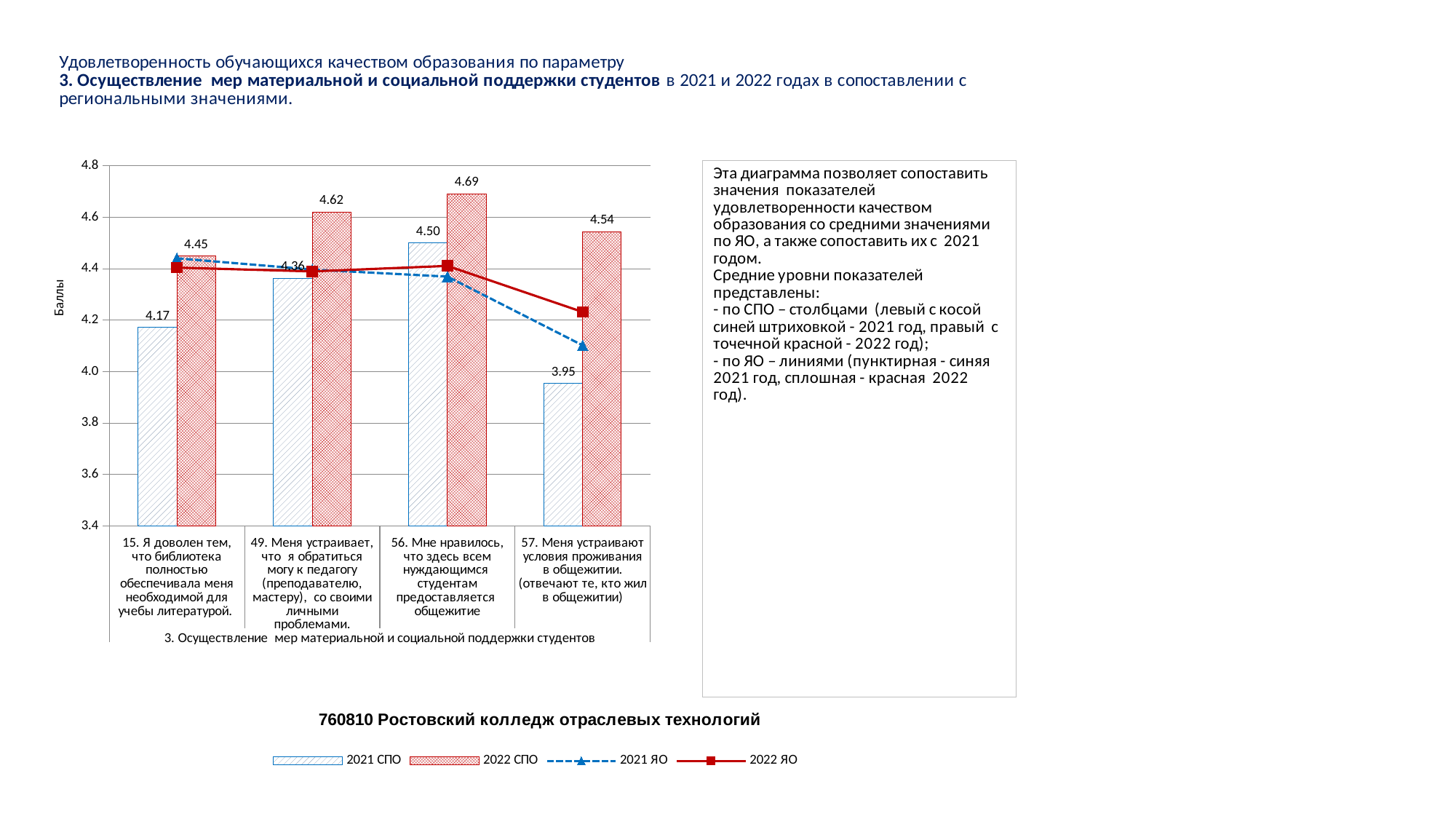
What is the 2022 СПО value for category 56 (Мне нравилось, что здесь всем нуждающимся студентам предоставляется общежитие)? 4.69 What is the difference between the 2022 СПО and 2021 СПО values for category 57? 0.59 Which category has the lowest 2021 СПО value? 57. Меня устраивают условия проживания в общежитии How many categories are shown on the x axis? 4 What is the 2021 СПО value for category 57 (Меня устраивают условия проживания в общежитии)? 3.95 Which is larger for category 15: the 2021 СПО value or the 2022 СПО value? 2022 СПО Do the 2022 СПО bar values rise or fall from category 49 to category 57? rise then fall How many series does the legend list? 4 Is the 2021 ЯО value for category 57 greater or less than 4.2? less What is the 2021 СПО value for category 15 (Я доволен тем, что библиотека полностью обеспечивала меня необходимой для учебы литературой)? 4.17 Which category has the highest 2022 СПО value? 56. Мне нравилось, что здесь всем нуждающимся студентам предоставляется общежитие What is the difference between the 2022 СПО and 2021 СПО values for category 49? 0.26